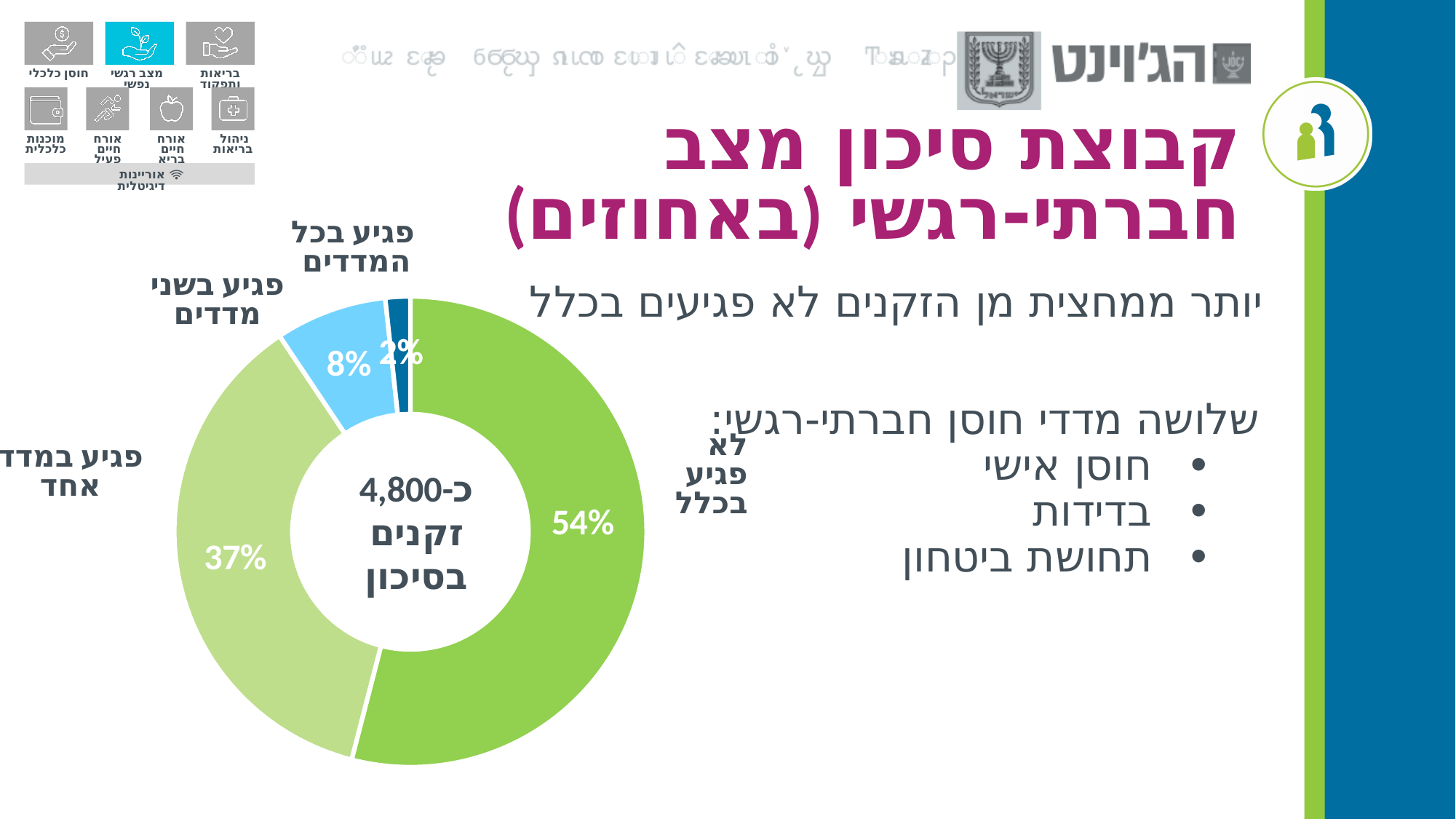
What is the combined share of the two categories "פגיע בשני מדדים" and "פגיע בכל המדדים"? 10% How many slices does the donut chart have? 4 What percentage of the chart is labelled "פגיע בכל המדדים"? 2% What percentage of the chart is labelled "פגיע בשני מדדים"? 8% What percentage of the chart is labelled "פגיע במדד אחד"? 37% Which category has the smallest share of the chart? פגיע בכל המדדים What percentage of the chart is labelled "לא פגיע בכלל"? 54% What text appears in the centre of the donut chart? כ-4,800 זקנים בסיכון What kind of chart is shown on the slide? Donut (pie) chart What is the difference in percentage points between "לא פגיע בכלל" and "פגיע במדד אחד"? 17 Which category has the largest share of the chart? לא פגיע בכלל Which is larger: the share for "פגיע בשני מדדים" or the share for "פגיע בכל המדדים"? פגיע בשני מדדים